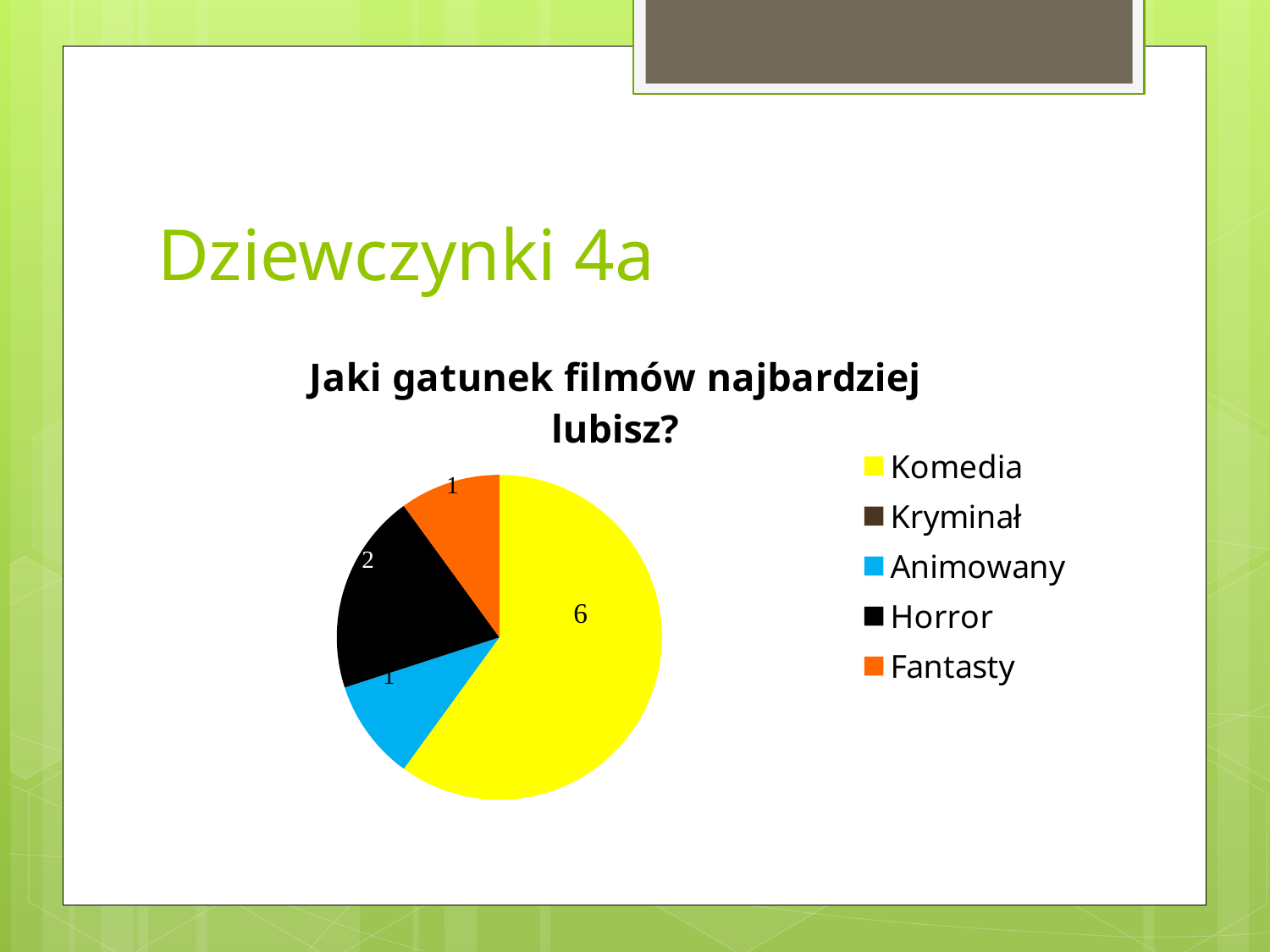
Which is larger, the value for Horror or the value for Animowany? Horror What colour is the Komedia slice in the pie chart? yellow What is the title of the pie chart? Jaki gatunek filmów najbardziej lubisz? What is the difference between the value for Horror and the value for Fantasty? 1 What is the value for Animowany in the pie chart? 1 What is the difference between the value for Komedia and the value for Horror? 4 What is the value for Fantasty in the pie chart? 1 What is the value for Komedia in the pie chart? 6 How many entries does the legend of the pie chart list? 5 What is the value for Horror in the pie chart? 2 Which category has the largest slice in the pie chart? Komedia What kind of chart is shown on the slide? pie chart